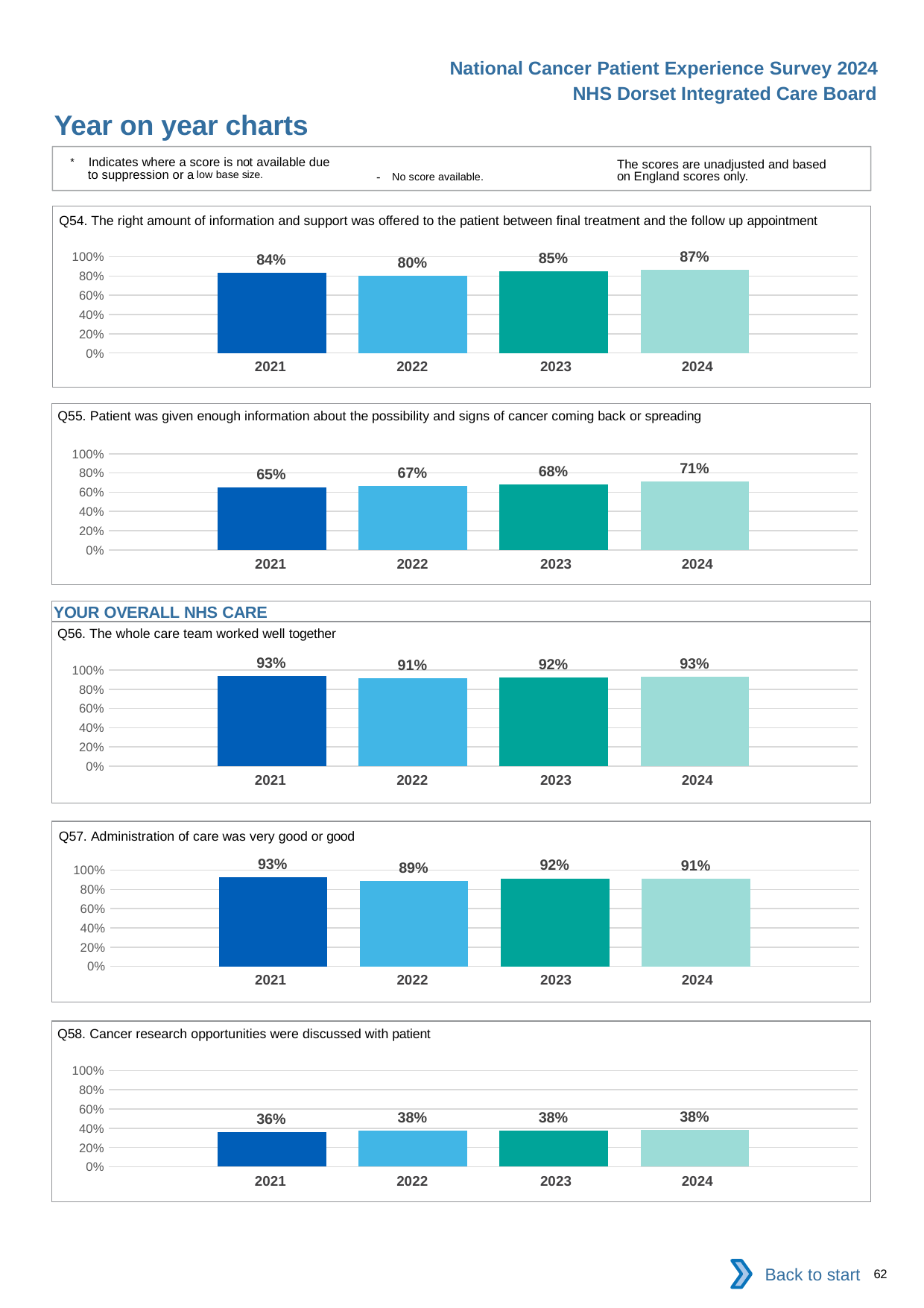
In the Q58 chart, is the value for 2021 greater or less than 40%? less In the Q54 chart, which year has the highest value? 2024 How many years are shown on the x axis of the Q58 chart? 4 In the Q56 chart, which year has the lowest value? 2022 In the Q57 chart, which is larger, the value for 2021 or the value for 2022? 2021 What kind of chart is the Q54 chart? bar chart In the Q58 chart, what is the value for 2023? 38% In the Q54 chart, what is the value for 2022? 80% In the Q55 chart, what is the difference between the 2024 and 2021 values? 6 percentage points In the Q55 chart, do the values rise or fall from 2021 to 2024? rise In the Q56 chart, what is the value for 2023? 92% In the Q57 chart, what is the value for 2024? 91%